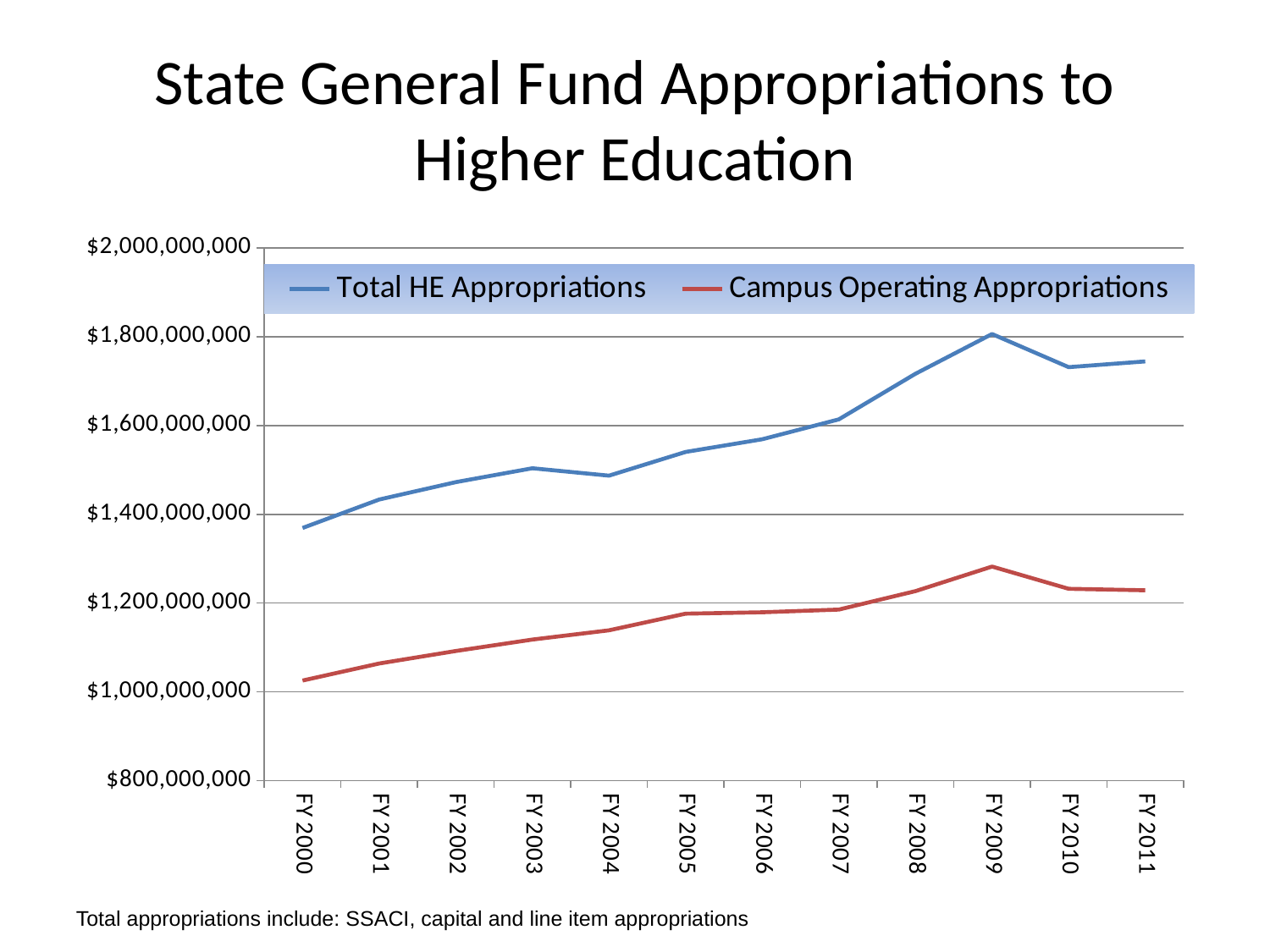
Is the value for Total HE Appropriations in FY 2000 greater or less than $1,400,000,000? less Which is larger for Total HE Appropriations: FY 2009 or FY 2010? FY 2009 What kind of chart is shown on the slide? Line chart What is the title of the chart? State General Fund Appropriations to Higher Education Is the value for Total HE Appropriations in FY 2005 greater or less than $1,600,000,000? less Is the value for Campus Operating Appropriations in FY 2009 greater or less than $1,200,000,000? greater How many fiscal years are plotted along the x axis? 12 In which fiscal year is Total HE Appropriations highest? FY 2009 In which fiscal year is Campus Operating Appropriations lowest? FY 2000 Which is larger in FY 2005: Total HE Appropriations or Campus Operating Appropriations? Total HE Appropriations How many series does the legend list? 2